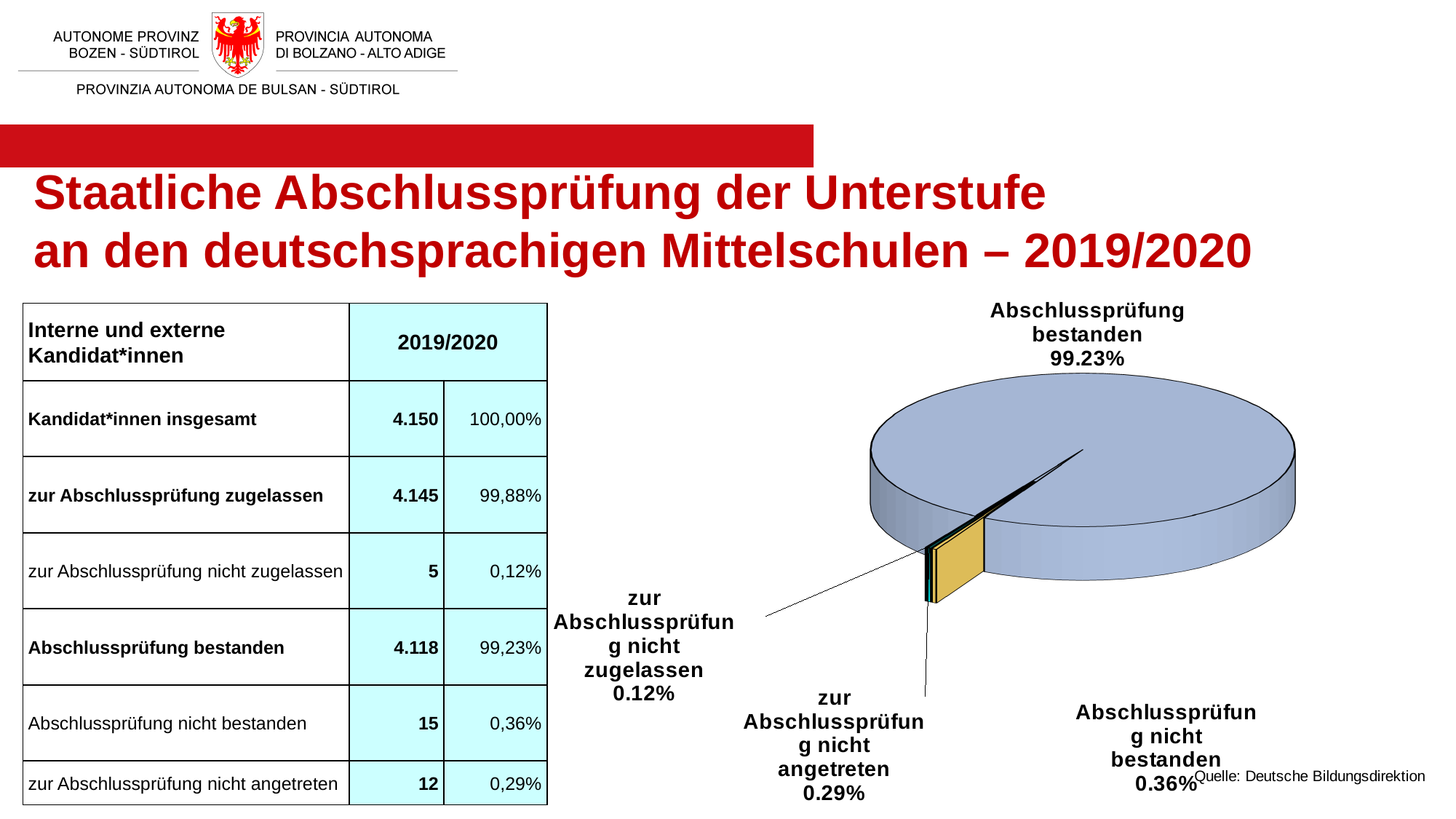
In the pie chart, what is the difference between the shares for "Abschlussprüfung nicht bestanden" and "zur Abschlussprüfung nicht zugelassen"? 0.24% Which slice of the pie chart is the largest? Abschlussprüfung bestanden What kind of chart is shown on the slide? pie chart What share of the pie chart is labelled "zur Abschlussprüfung nicht angetreten"? 0.29% Which slice of the pie chart is the smallest? zur Abschlussprüfung nicht zugelassen What share of the pie chart is labelled "Abschlussprüfung nicht bestanden"? 0.36% How many slices does the pie chart have? 4 In the pie chart, what is the difference between the shares for "zur Abschlussprüfung nicht angetreten" and "zur Abschlussprüfung nicht zugelassen"? 0.17% In the pie chart, which is larger: "Abschlussprüfung nicht bestanden" or "zur Abschlussprüfung nicht angetreten"? Abschlussprüfung nicht bestanden What share of the pie chart is labelled "Abschlussprüfung bestanden"? 99.23% What colour is the largest slice of the pie chart? light blue